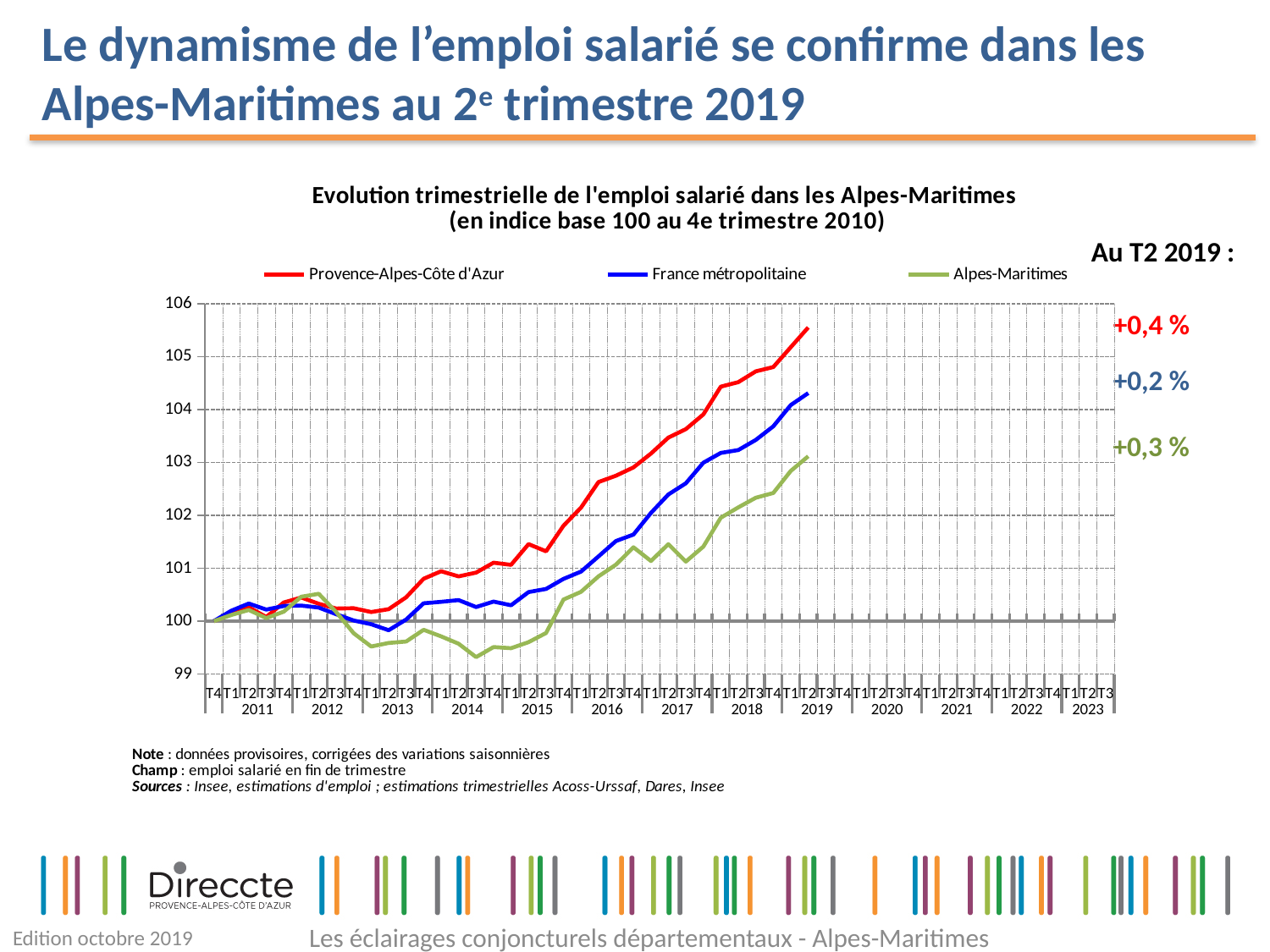
According to the annotation, what is the quarterly change for Alpes-Maritimes at T2 2019? +0,3 % Is the index value for Alpes-Maritimes at T2 2014 greater or less than 100? less What is the title of the chart? Evolution trimestrielle de l'emploi salarié dans les Alpes-Maritimes (en indice base 100 au 4e trimestre 2010) Is the index value for Provence-Alpes-Côte d'Azur at T2 2019 greater or less than 105? greater What kind of chart is shown on the slide? line chart Which series has the highest index value at T2 2019? Provence-Alpes-Côte d'Azur Does the France métropolitaine series rise or fall between 2015 and 2019? rise According to the annotation, what is the quarterly change for Provence-Alpes-Côte d'Azur at T2 2019? +0,4 % Which series has the lowest index value at T2 2019? Alpes-Maritimes According to the annotation, what is the quarterly change for France métropolitaine at T2 2019? +0,2 % Which series is drawn in red? Provence-Alpes-Côte d'Azur How many series does the legend list? 3